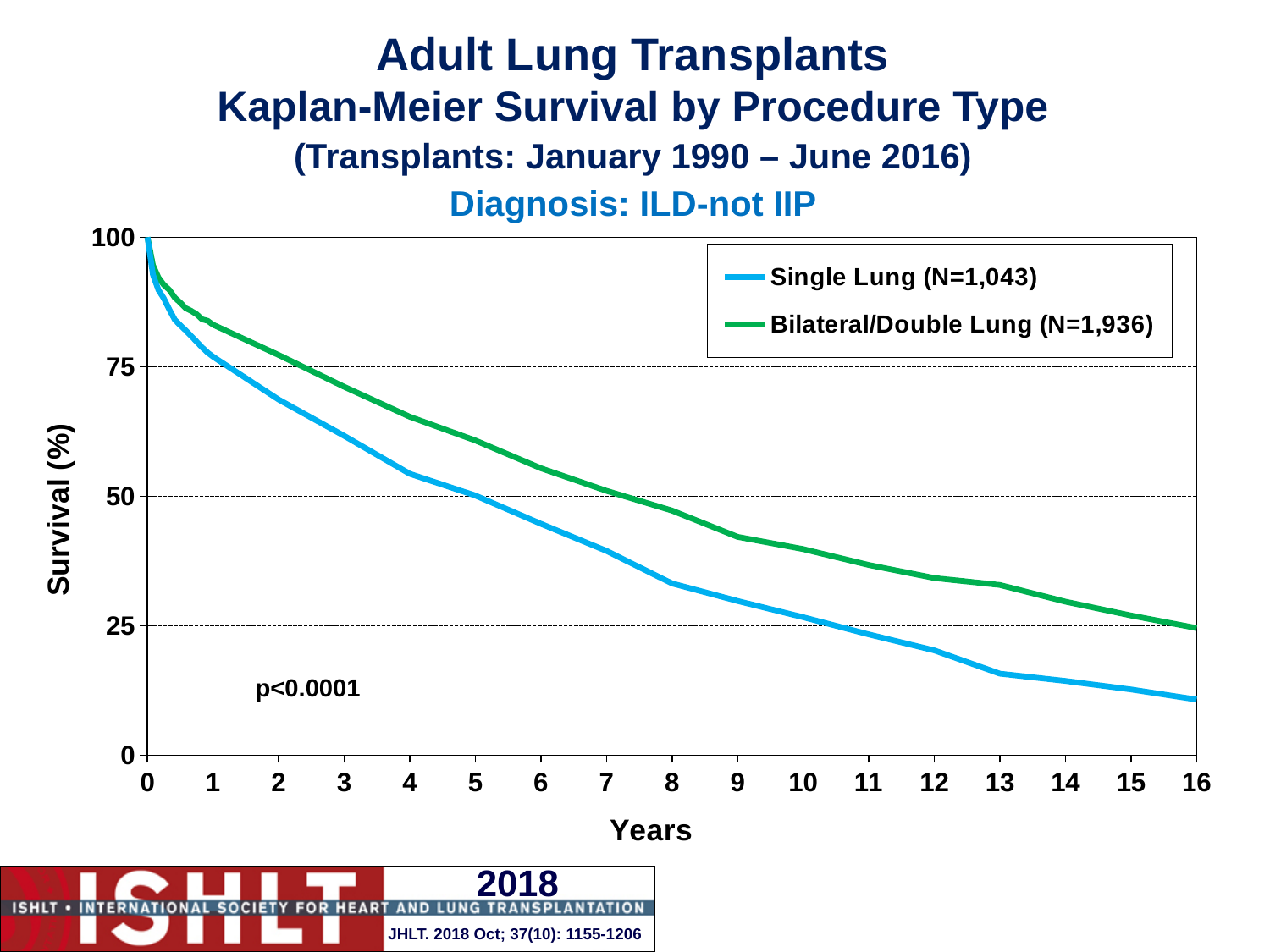
Which procedure type has the higher survival curve across the years shown? Bilateral/Double Lung What p-value is printed on the chart? p<0.0001 Is the survival for Single Lung at 12 years greater or less than 25? less How many series does the legend list? 2 At 8 years, which group has higher survival, Single Lung or Bilateral/Double Lung? Bilateral/Double Lung What is the N for the Bilateral/Double Lung group shown in the legend? 1,936 Is the survival for Single Lung at 8 years greater or less than 50? less What kind of chart is shown on the slide? line chart Is the survival for Bilateral/Double Lung at 4 years greater or less than 50? greater Do the survival curves rise or fall as years increase? fall What is the N for the Single Lung group shown in the legend? 1,043